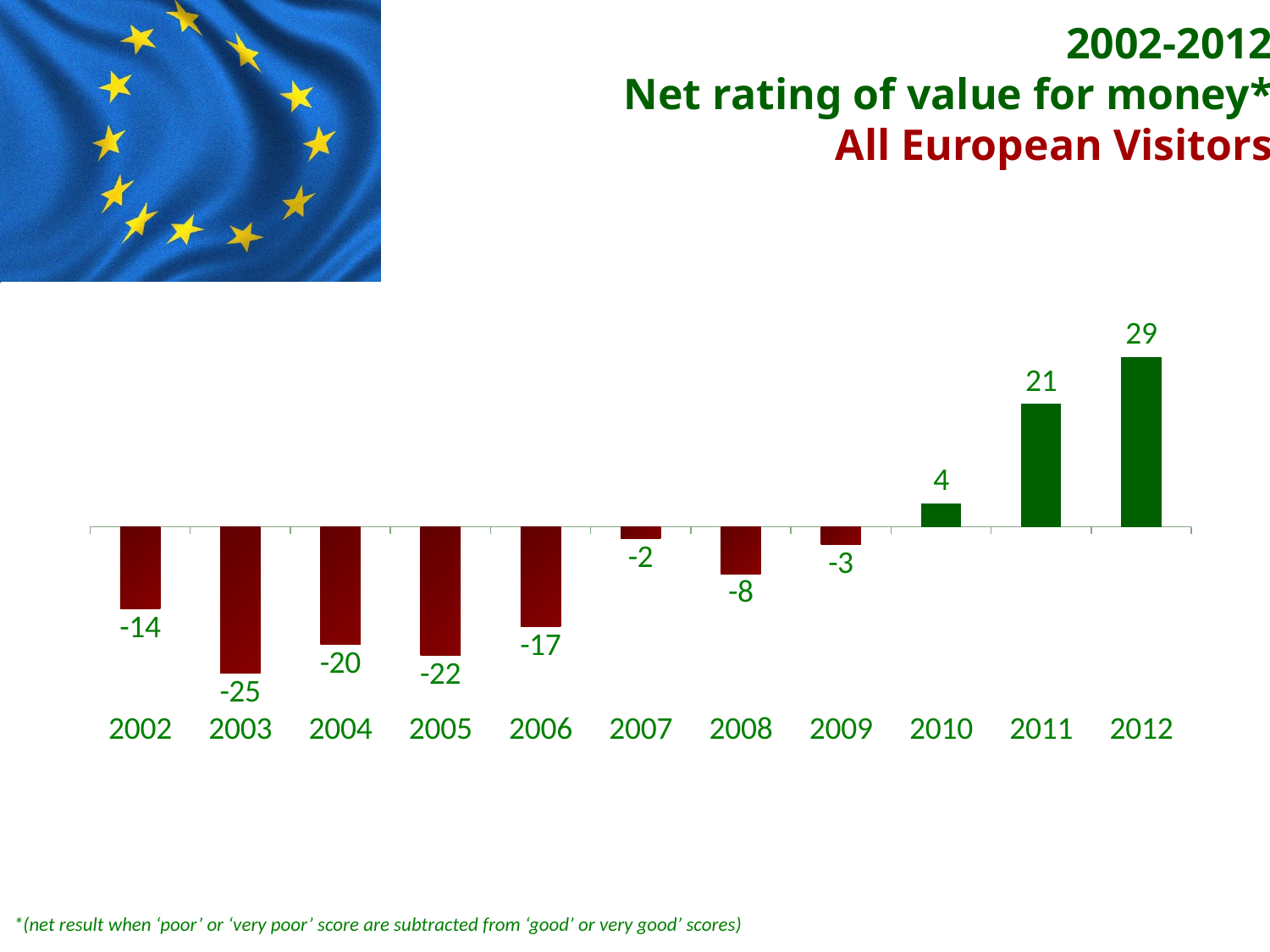
What is the net rating of value for money for 2003? -25 Which year has the lowest net rating of value for money? 2003 What is the net rating of value for money for 2010? 4 Do the net ratings generally rise or fall from 2006 to 2012? Rise What is the net rating of value for money for 2012? 29 Which year has a higher net rating, 2008 or 2009? 2009 What is the difference between the net rating in 2012 and the net rating in 2011? 8 How many years are shown on the chart? 11 What kind of chart is shown on the slide? Bar chart What is the difference between the net rating in 2005 and the net rating in 2006? 5 Which year has the highest net rating of value for money? 2012 What is the net rating of value for money for 2007? -2